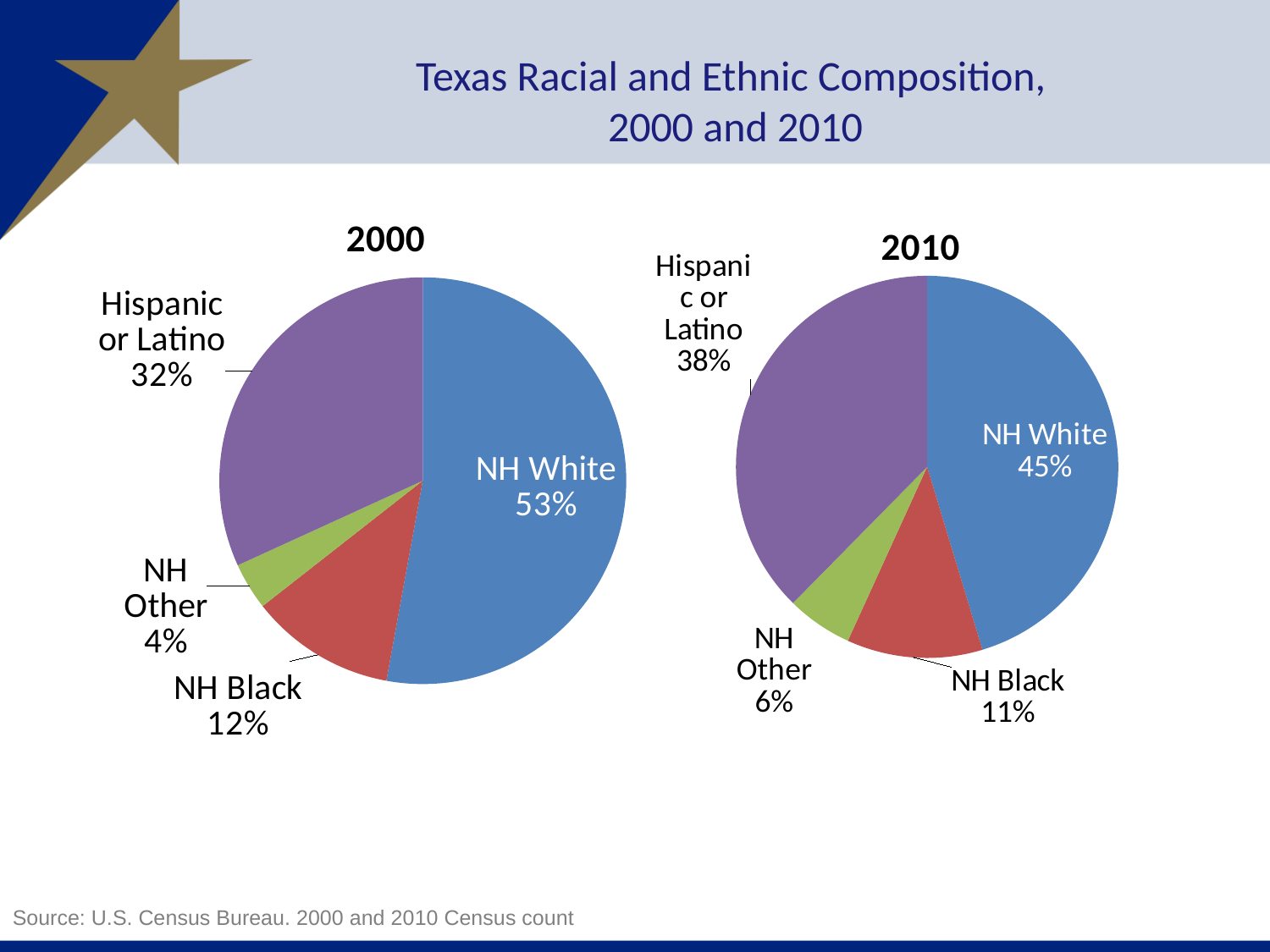
In the 2000 pie chart, what share is NH Black? 12% In the 2010 pie chart, what share is Hispanic or Latino? 38% What is the title of the slide containing the two pie charts? Texas Racial and Ethnic Composition, 2000 and 2010 Which is larger: the Hispanic or Latino share in 2000 or in 2010? 2010 What kind of chart is used to show the 2000 composition? Pie chart In the 2010 pie chart, which group has the largest share? NH White What is the difference between the NH White share in 2000 and in 2010? 8 percentage points What is the difference between the NH Black share in 2000 and in 2010? 1 percentage point In the 2000 pie chart, what share is NH White? 53% In the 2010 pie chart, what share is NH Other? 6% In the 2000 pie chart, which group has the smallest share? NH Other How many slices does the 2010 pie chart have? 4